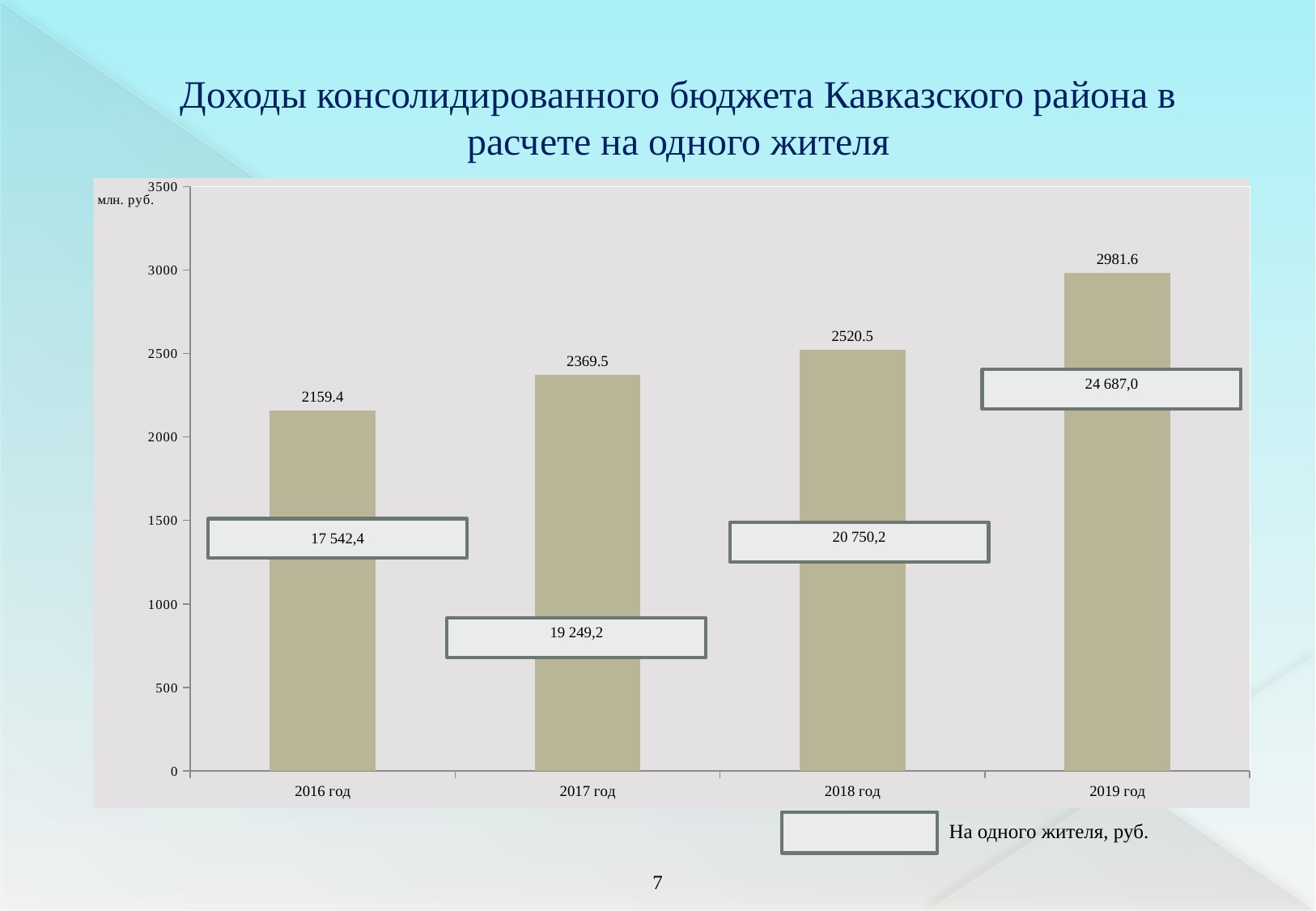
Which year has the highest bar? 2019 год Is the value for 2017 год greater or less than 2500? less What is the value of the bar for 2019 год? 2981.6 What is the value of the bar for 2016 год? 2159.4 Which year has the lowest bar? 2016 год What is the difference between the bar values for 2019 год and 2018 год? 461.1 What per-capita value (На одного жителя, руб.) is shown in the box for 2017 год? 19 249,2 What is the value of the bar for 2018 год? 2520.5 How many bars are shown in the chart? 4 Which bar is larger, 2017 год or 2018 год? 2018 год What kind of chart is shown on the slide? bar chart Do the bar values rise or fall from 2016 год to 2019 год? rise